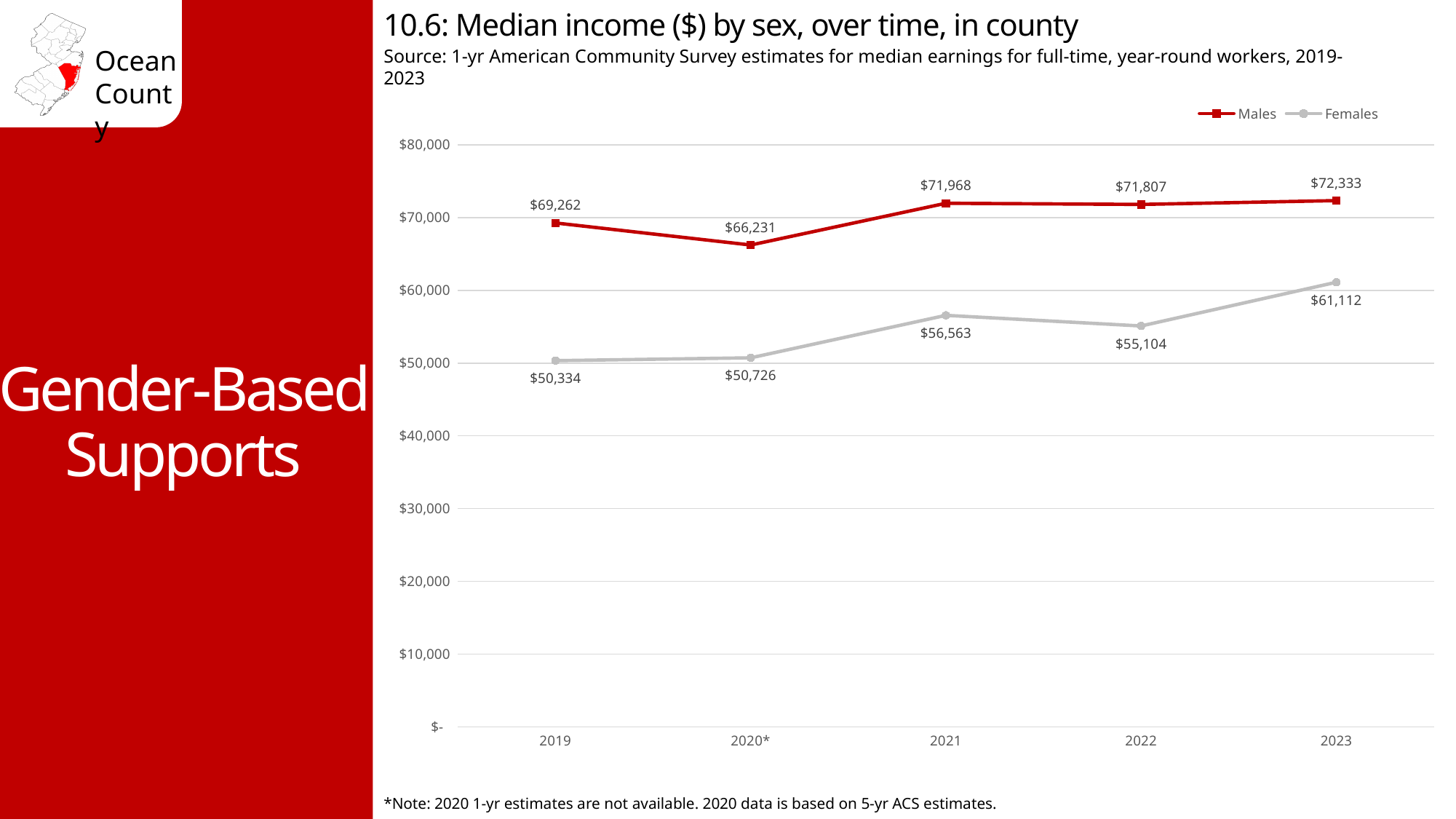
What was the median income for Females in 2020*? $50,726 In which year was the median income for Females the lowest? 2019 How much did the Females median income increase from 2022 to 2023? $6,008 How many years are shown on the x axis? 5 What was the median income for Males in 2021? $71,968 What kind of chart is shown on the slide? Line chart What was the median income for Females in 2022? $55,104 Which was larger in 2019: the median income for Males or for Females? Males How many series does the legend list? 2 In which year was the median income for Males the lowest? 2020* In which year was the median income for Males the highest? 2023 What is the difference between the Males and Females median income in 2023? $11,221